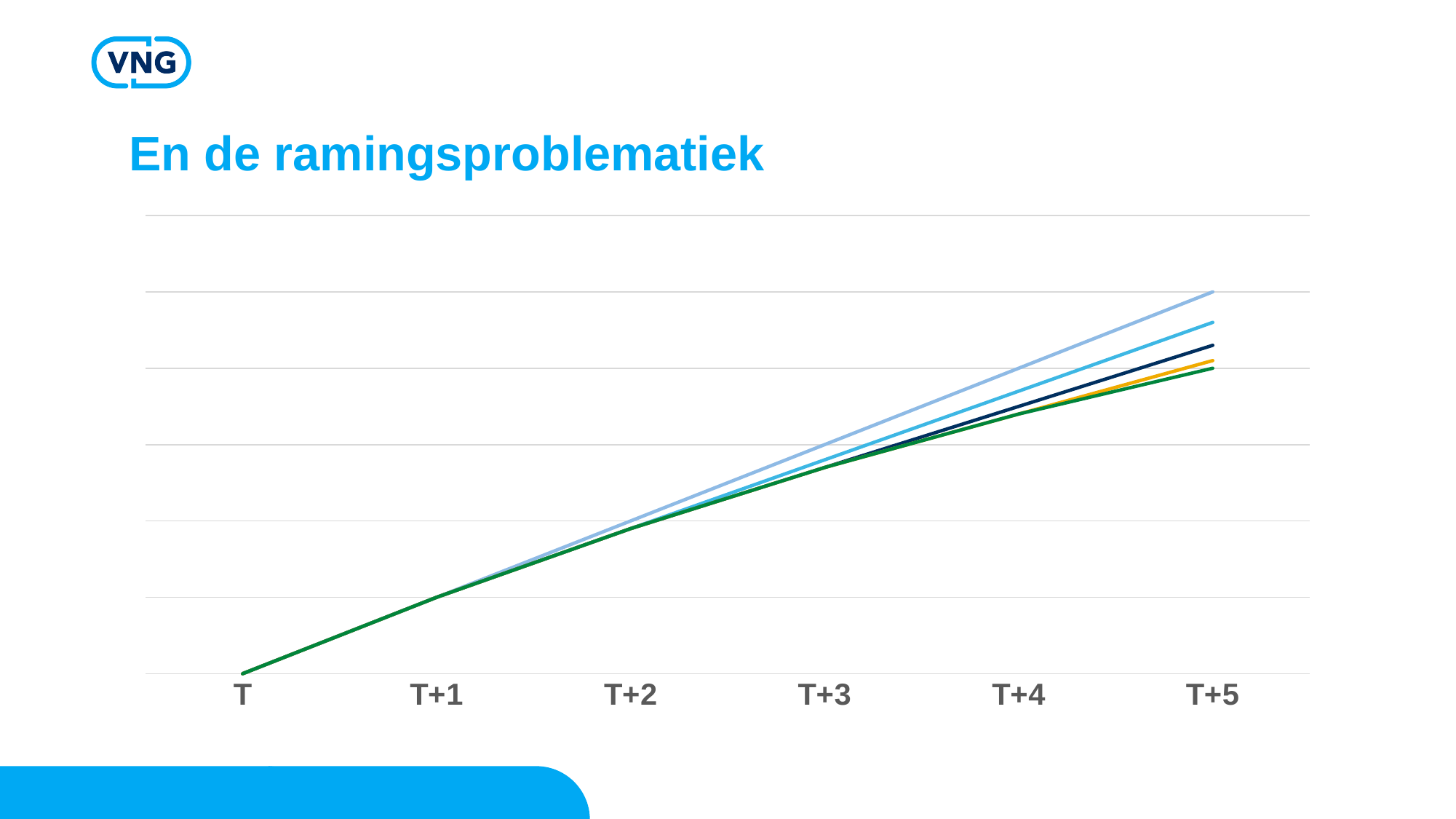
Which coloured line is highest at T+5? the light blue line At T+5, is the light blue line higher or lower than the green line? higher What kind of chart is shown on the slide? line chart Do the lines in the chart rise or fall from T to T+5? rise At T+5, is the dark blue line higher or lower than the cyan line? lower What is the last category label on the x axis of the chart? T+5 What is the first category label on the x axis of the chart? T Do the lines in the chart start from the same point at T or from different points? the same point Which coloured line is lowest at T+5? the green line How many lines are plotted in the chart? 5 How many categories are shown on the x axis of the chart? 6